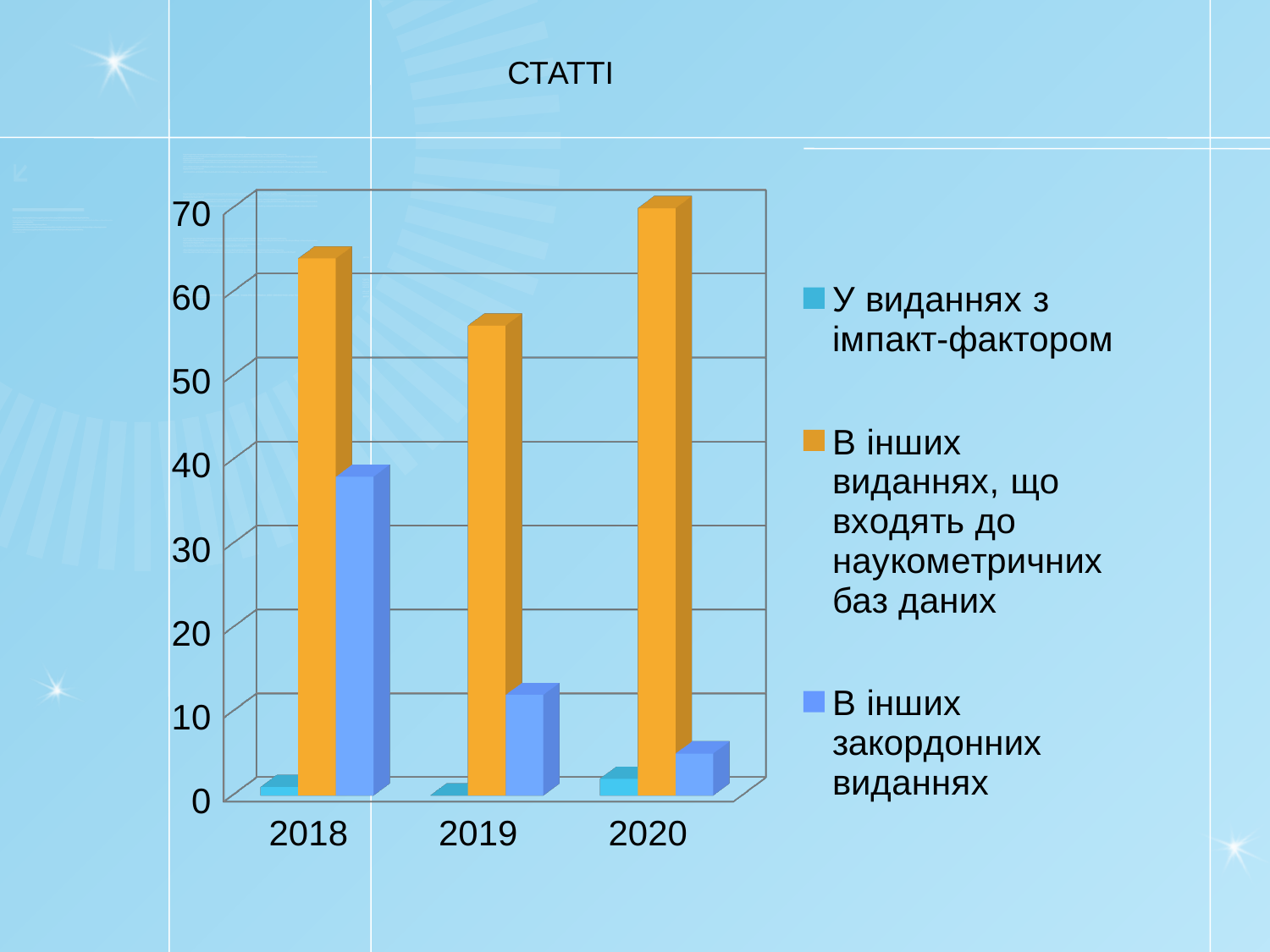
Is the value for 'В інших закордонних виданнях' in 2019 greater or less than 20? less Which year has the highest value for the series 'В інших виданнях, що входять до наукометричних баз даних'? 2020 Which year has the highest value for the series 'В інших закордонних виданнях'? 2018 What kind of chart is shown on the slide? bar chart Which is larger in 2020: the value for 'В інших закордонних виданнях' or the value for 'В інших виданнях, що входять до наукометричних баз даних'? В інших виданнях, що входять до наукометричних баз даних Is the value for 'В інших виданнях, що входять до наукометричних баз даних' in 2018 greater or less than 60? greater How many years are shown on the x axis? 3 Is the value for 'В інших закордонних виданнях' in 2018 greater or less than 30? greater How many series does the legend list? 3 Which year has the lowest value for the series 'В інших виданнях, що входять до наукометричних баз даних'? 2019 Do the values for 'В інших закордонних виданнях' rise or fall from 2018 to 2020? fall What is the title of the chart? СТАТТІ